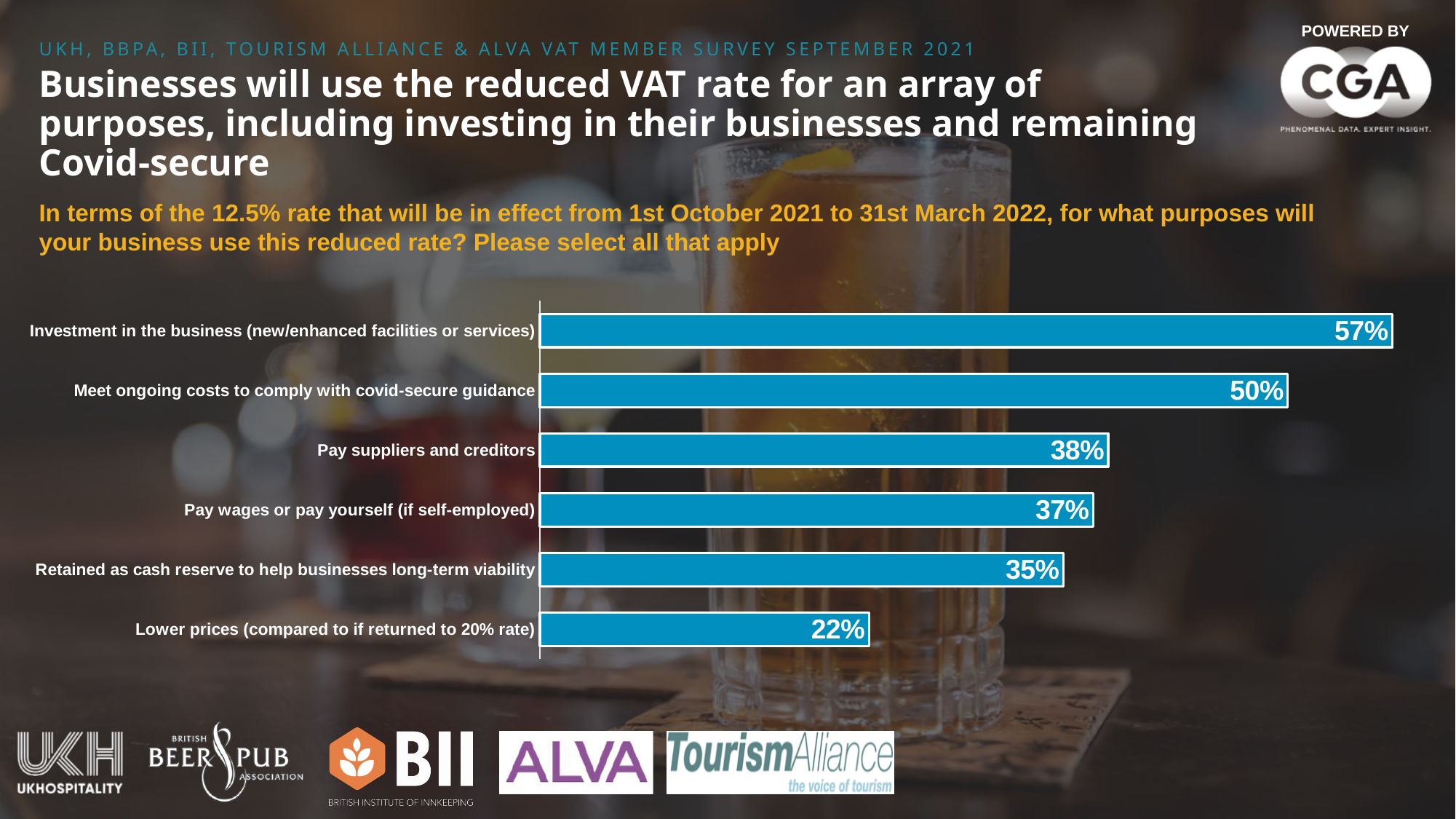
What is the value for 'Meet ongoing costs to comply with covid-secure guidance'? 50% What type of chart is used on this slide? Bar chart Which is larger: the value for 'Pay suppliers and creditors' or the value for 'Retained as cash reserve to help businesses long-term viability'? Pay suppliers and creditors Which purpose has the highest percentage in the chart? Investment in the business (new/enhanced facilities or services) What is the difference in percentage points between 'Investment in the business' and 'Meet ongoing costs to comply with covid-secure guidance'? 7 percentage points What percentage of businesses said they will use the reduced VAT rate for investment in the business (new/enhanced facilities or services)? 57% What colour are the bars in the chart? Blue What is the difference between 'Pay wages or pay yourself (if self-employed)' and 'Lower prices (compared to if returned to 20% rate)'? 15 percentage points Which purpose has the lowest percentage in the chart? Lower prices (compared to if returned to 20% rate) How many purposes (categories) are shown in the chart? 6 What is the value for 'Lower prices (compared to if returned to 20% rate)'? 22% What percentage is shown for 'Pay suppliers and creditors'? 38%